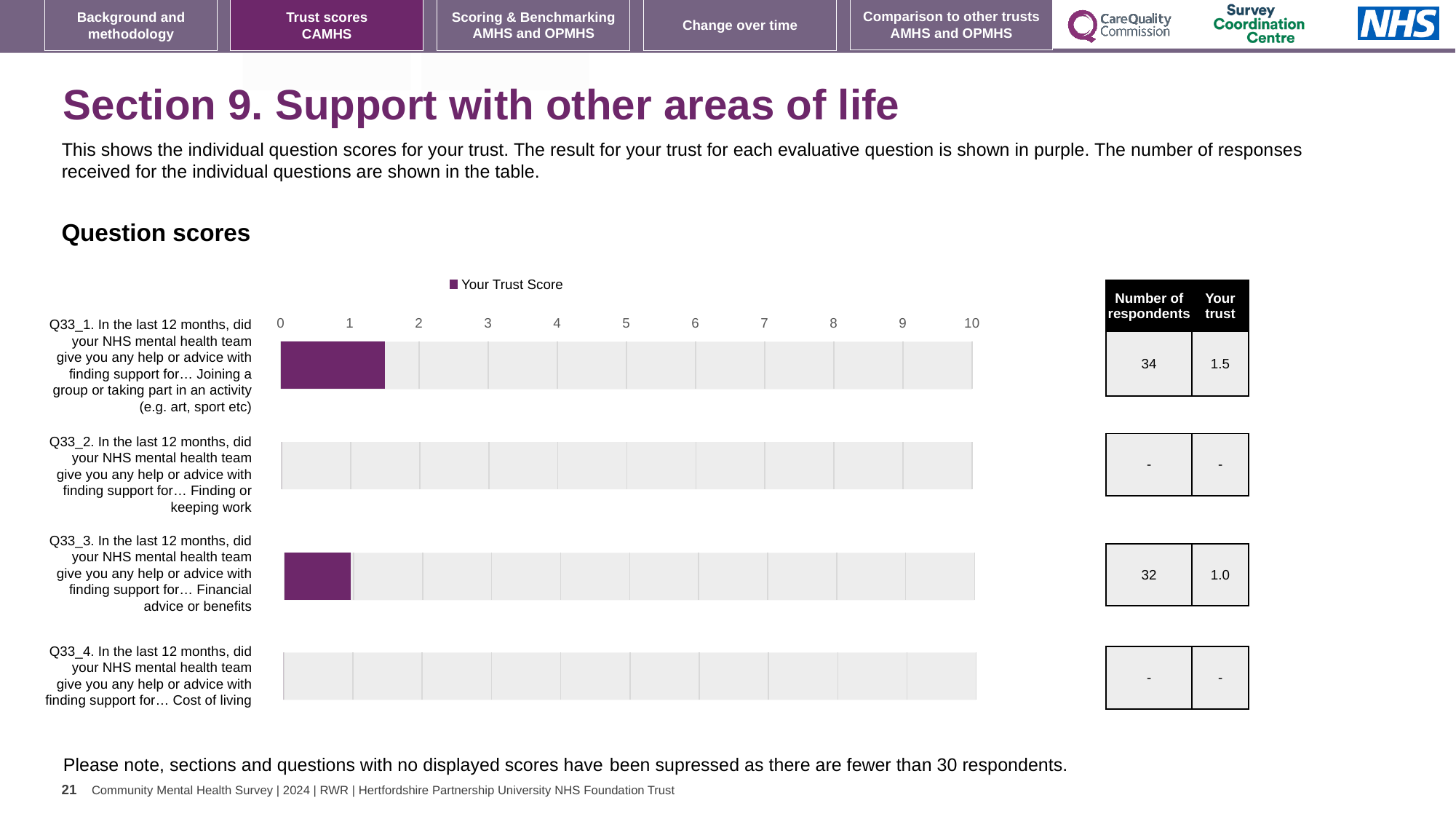
Which question has the highest Your Trust Score on the chart? Q33_1 (Joining a group or taking part in an activity) What is the difference between the Your Trust Score for Q33_1 and Q33_3? 0.5 What is the Your Trust Score for Q33_3 (Financial advice or benefits)? 1.0 How many questions (categories) are listed on the chart? 4 What type of chart is shown on the slide? Bar chart Which has a larger Your Trust Score, Q33_1 (Joining a group) or Q33_3 (Financial advice or benefits)? Q33_1 (Joining a group) How many respondents answered Q33_1 (Joining a group or taking part in an activity)? 34 How many respondents answered Q33_3 (Financial advice or benefits)? 32 How many series does the chart legend list? 1 What is the name of the series shown in the chart legend? Your Trust Score What is the Your Trust Score for Q33_1 (Joining a group or taking part in an activity)? 1.5 Is the Your Trust Score for Q33_1 greater or less than 2? less